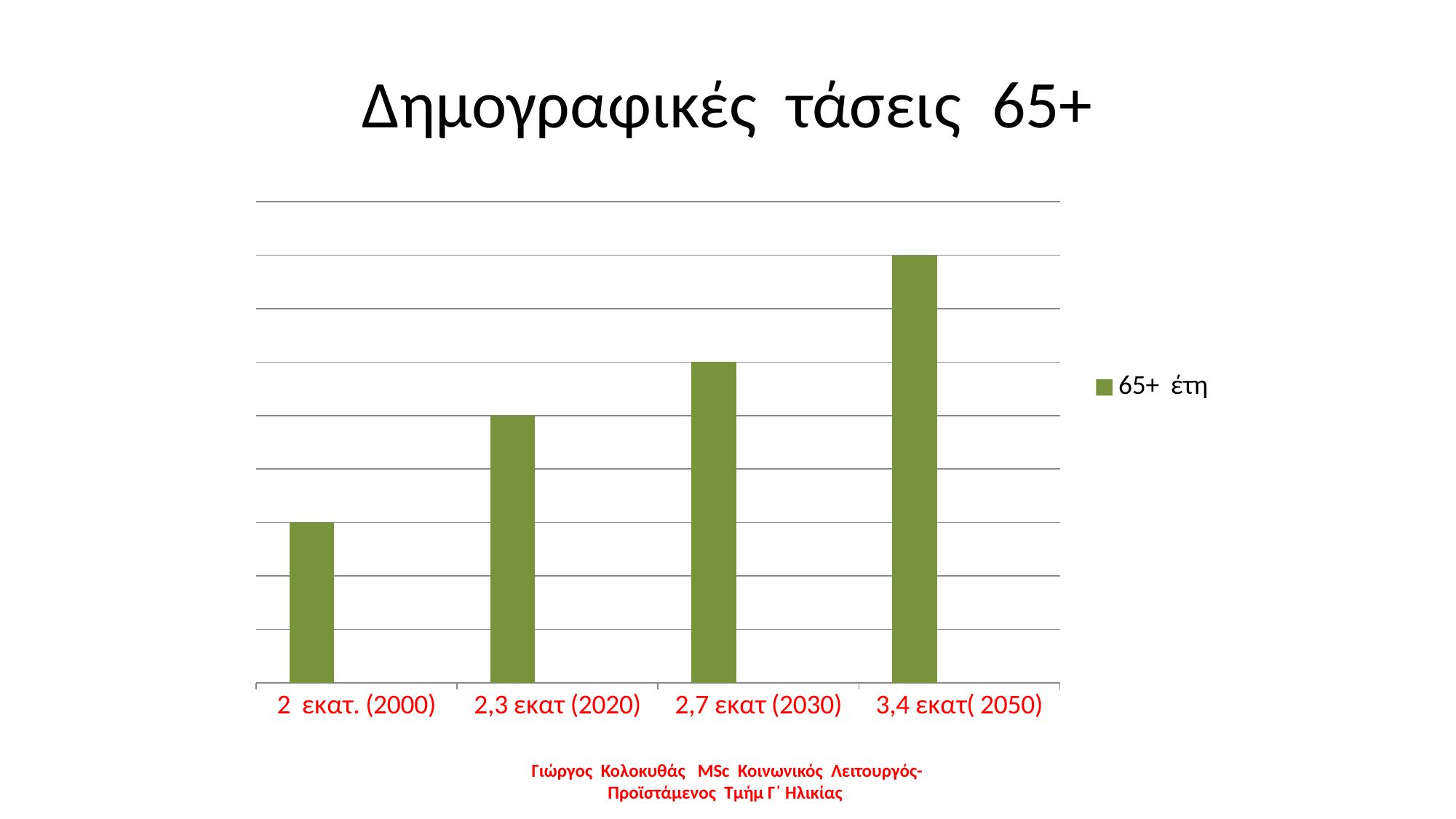
What kind of chart is shown on the slide? bar chart Which category has the tallest bar? 3,4 εκατ( 2050) How many bars are plotted in the chart? 4 According to the category label, what population value is given for 2050? 3,4 εκατ According to the category label, what population value is given for 2030? 2,7 εκατ What is the title of the chart? Δημογραφικές τάσεις 65+ Do the bar values rise or fall from left to right along the x axis? rise Which bar is taller: the one for 2000 or the one for 2050? 2050 How many series does the legend list? 1 Which bar is taller: the one for 2020 or the one for 2030? 2030 What is the legend entry for the series? 65+ έτη Which category has the shortest bar? 2 εκατ. (2000)